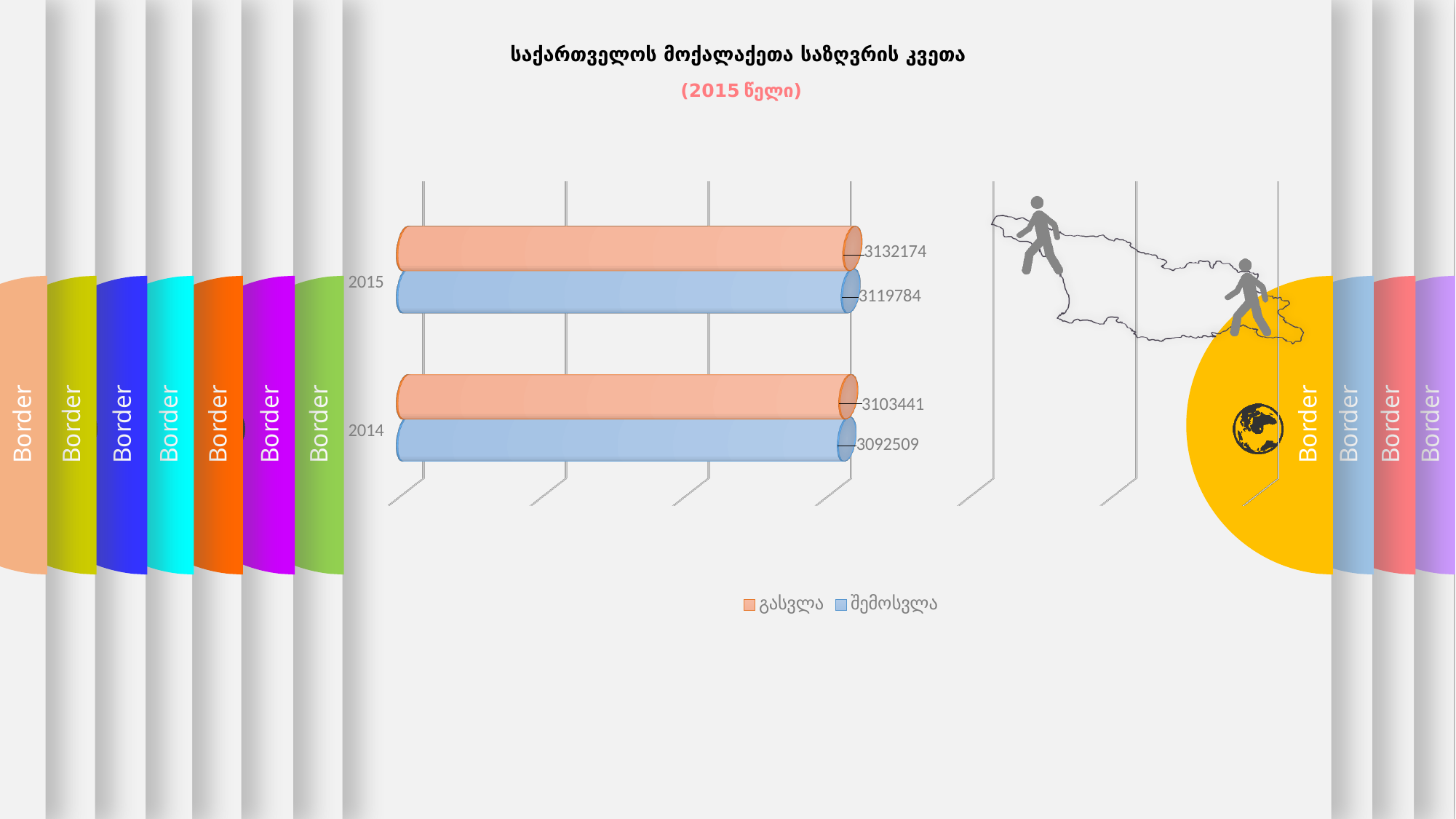
How many years (categories) are shown on the chart? 2 How many series does the legend list? 2 What is the value of შემოსვლა for 2015? 3119784 Which bar has the highest value on the chart? გასვლა for 2015 What is the value of შემოსვლა for 2014? 3092509 What type of chart is shown on the slide? Bar chart What is the value of გასვლა for 2015? 3132174 What is the difference between გასვლა in 2015 and გასვლა in 2014? 28733 What is the difference between გასვლა and შემოსვლა in 2015? 12390 What is the value of გასვლა for 2014? 3103441 Which bar has the lowest value on the chart? შემოსვლა for 2014 Which is larger in 2014, გასვლა or შემოსვლა? გასვლა